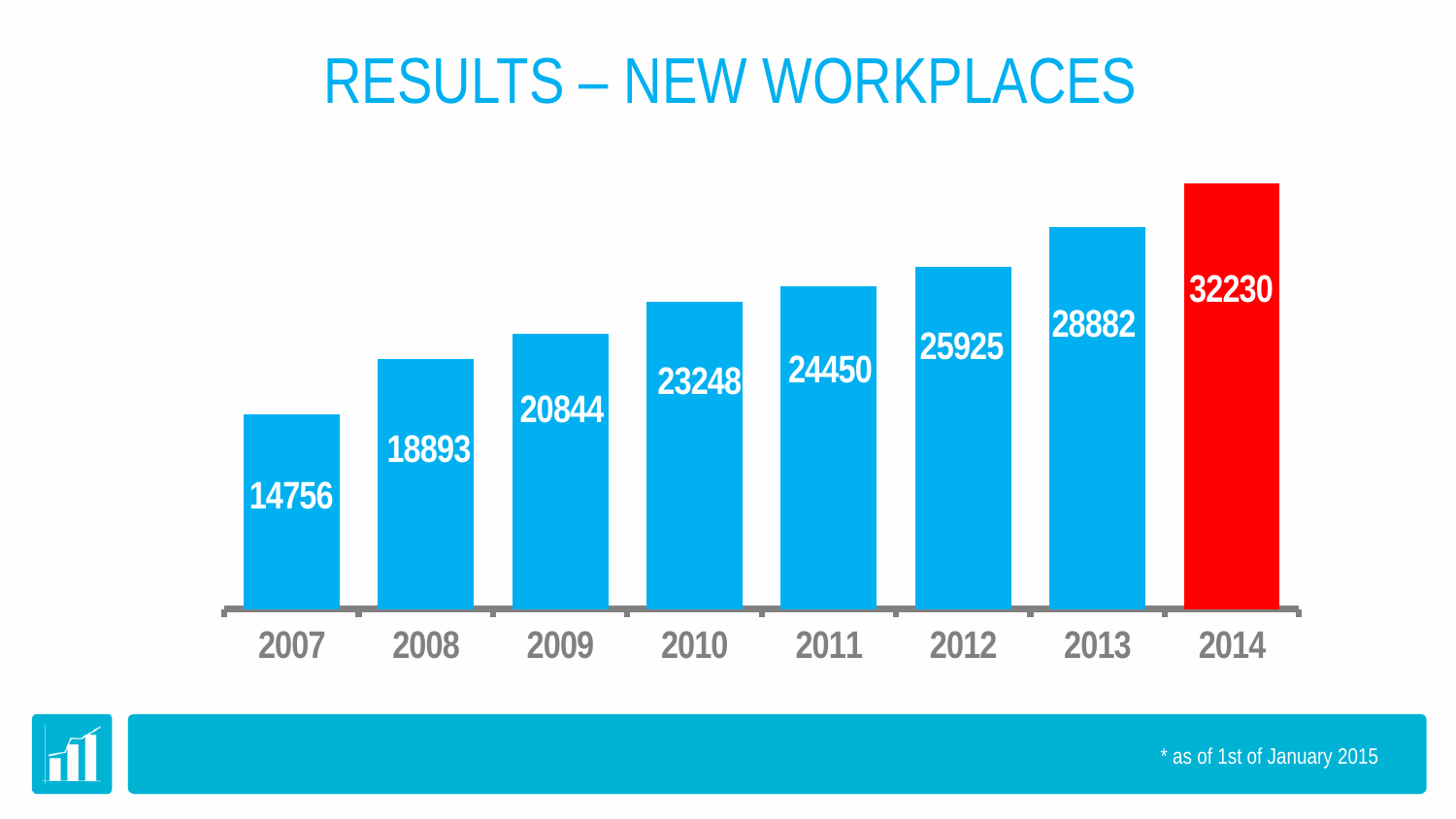
Which is larger, the value for 2010 or the value for 2012? 2012 What is the difference between the values for 2014 and 2013? 3348 What kind of chart is shown on the slide? bar chart What is the difference between the values for 2008 and 2007? 4137 Which year has the lowest value? 2007 What is the value for 2014? 32230 What is the value for 2011? 24450 How many years are shown on the chart? 8 Which year has the highest value? 2014 Do the values rise or fall from 2007 to 2014? rise What is the value for 2007? 14756 Which bar is coloured red? 2014